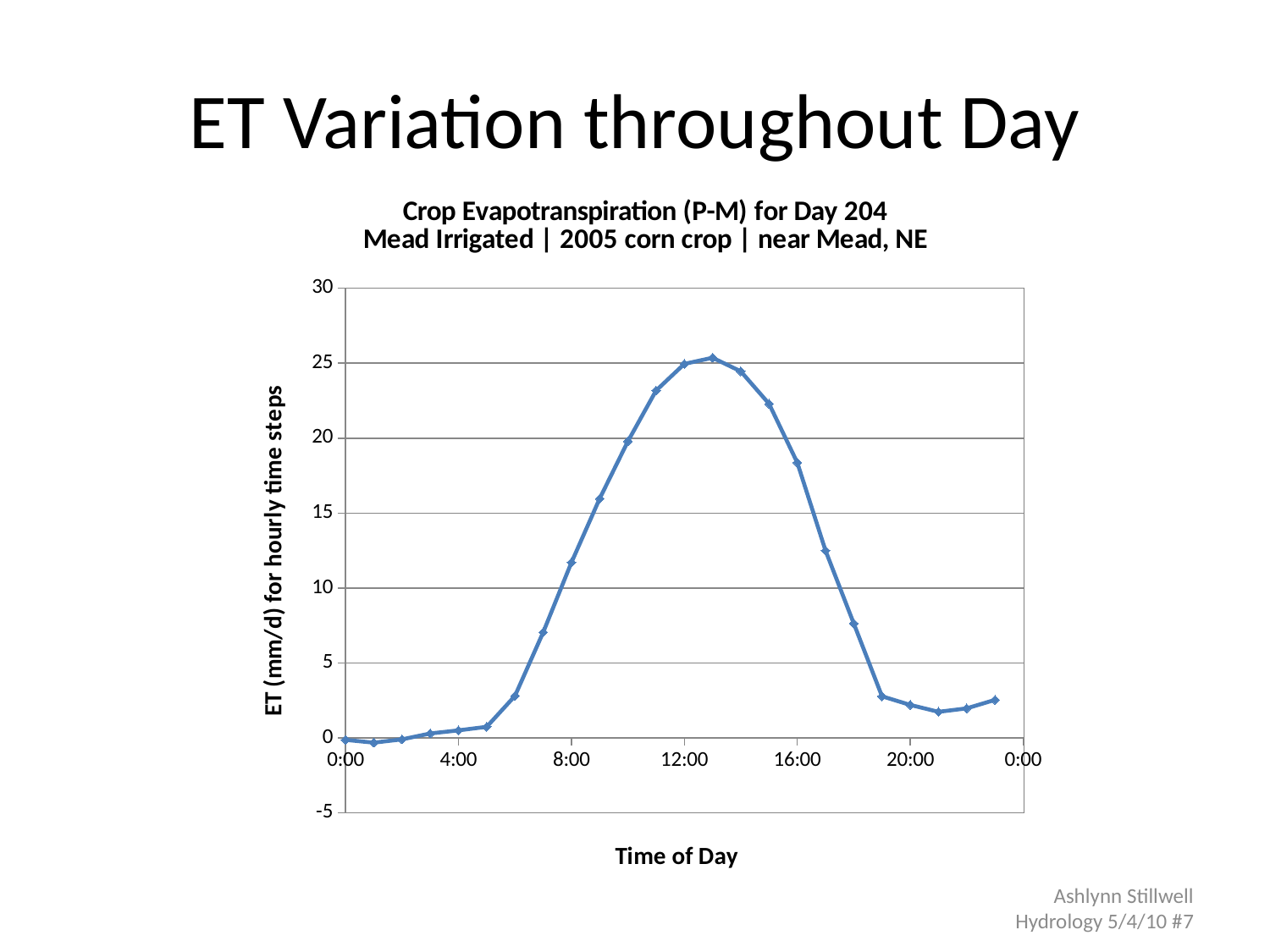
Is the ET value at 4:00 greater or less than 5? less Is the ET value at 20:00 greater or less than 5? less Is the ET value at 16:00 greater or less than 15? greater Do the ET values rise or fall between 4:00 and 12:00? rise What is the label of the vertical axis? ET (mm/d) for hourly time steps Which time has the larger ET value, 4:00 or 20:00? 20:00 What is the title of the chart? Crop Evapotranspiration (P-M) for Day 204 Mead Irrigated | 2005 corn crop | near Mead, NE What kind of chart is shown on the slide? line chart Do the ET values rise or fall between 14:00 and 19:00? fall Which time has the larger ET value, 8:00 or 16:00? 16:00